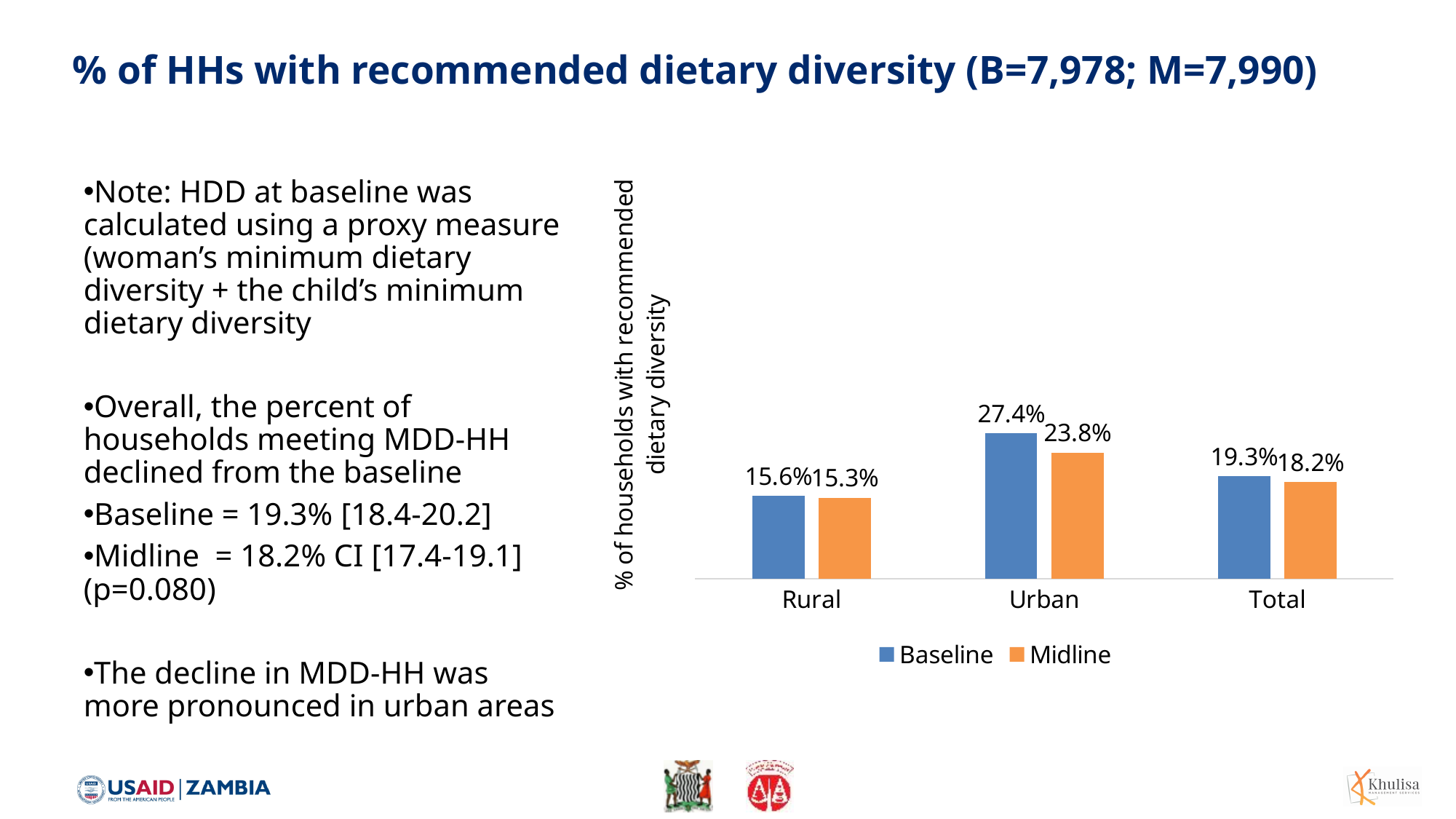
What is the difference between the Baseline and Midline values for Urban? 3.6% What kind of chart is shown on the slide? Bar chart What colour are the Midline bars? Orange What is the difference between the Urban and Rural Baseline values? 11.8% What is the Midline value for Rural? 15.3% How many categories are shown on the x axis? 3 Which category has the highest Baseline value? Urban What is the Baseline value for Urban? 27.4% How many series does the legend list? 2 Which category has the lowest Midline value? Rural What is the Midline value for Total? 18.2% Which is larger, the Baseline value for Total or the Midline value for Total? Baseline